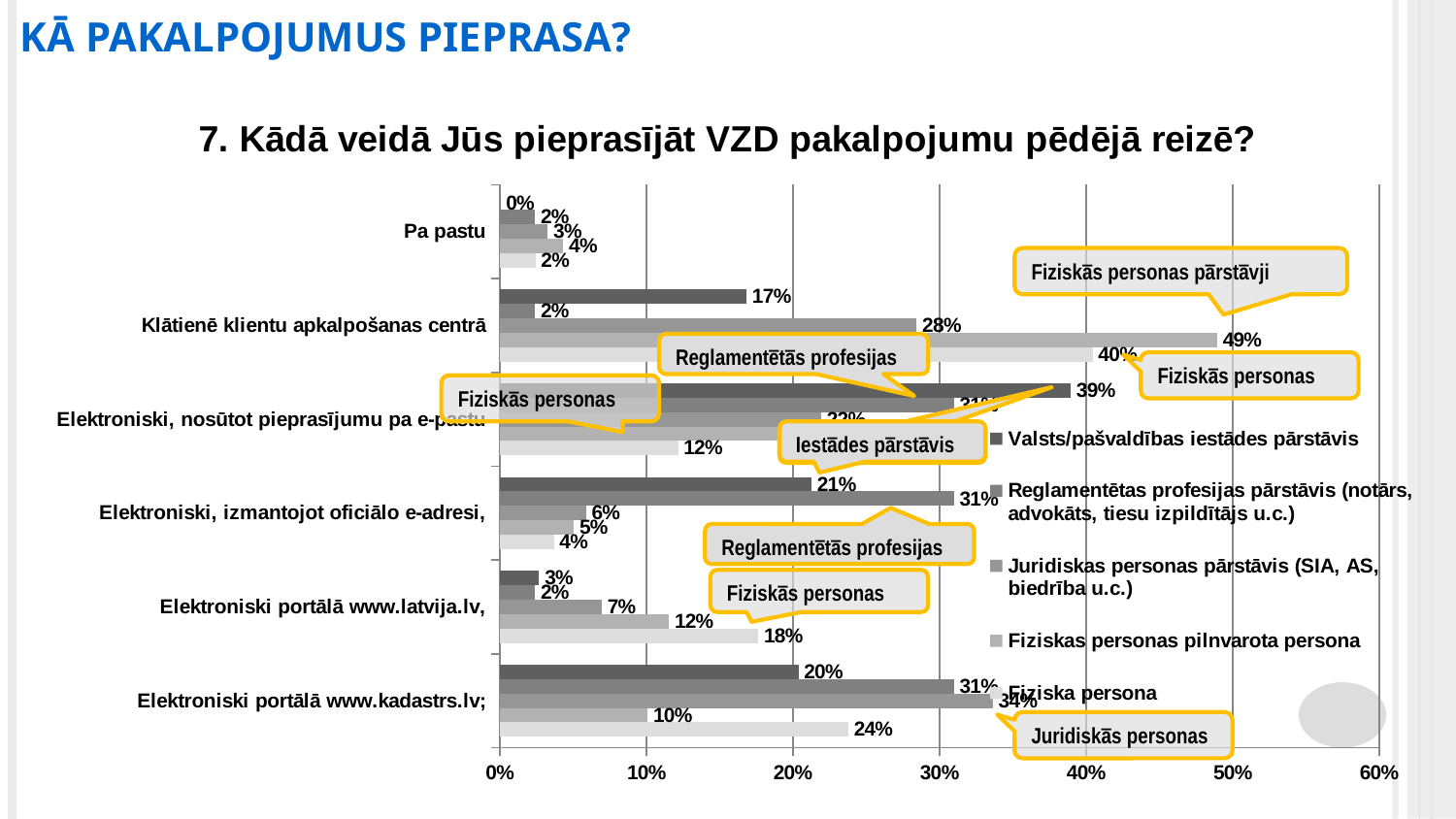
In which category does the Fiziska persona series have its highest value? Klātienē klientu apkalpošanas centrā What is the value for Fiziska persona in the category Elektroniski portālā www.latvija.lv? 18% How many series does the legend list? 5 What kind of chart is shown on the slide? bar chart What is the value for Fiziskas personas pilnvarota persona in the category Klātienē klientu apkalpošanas centrā? 49% What is the value for Fiziska persona in the category Elektroniski portālā www.kadastrs.lv? 24% In the category Elektroniski portālā www.kadastrs.lv, which is larger: Juridiskas personas pārstāvis or Reglamentētas profesijas pārstāvis? Juridiskas personas pārstāvis In the category Klātienē klientu apkalpošanas centrā, what is the difference between the Fiziskas personas pilnvarota persona value and the Fiziska persona value? 9 percentage points Is the value for Juridiskas personas pārstāvis in the category Klātienē klientu apkalpošanas centrā greater or less than 20%? greater How many categories (ways of requesting the service) are shown on the y axis? 6 Which series has the lowest value in the category Pa pastu? Valsts/pašvaldības iestādes pārstāvis What is the value for Valsts/pašvaldības iestādes pārstāvis in the category Klātienē klientu apkalpošanas centrā? 17%